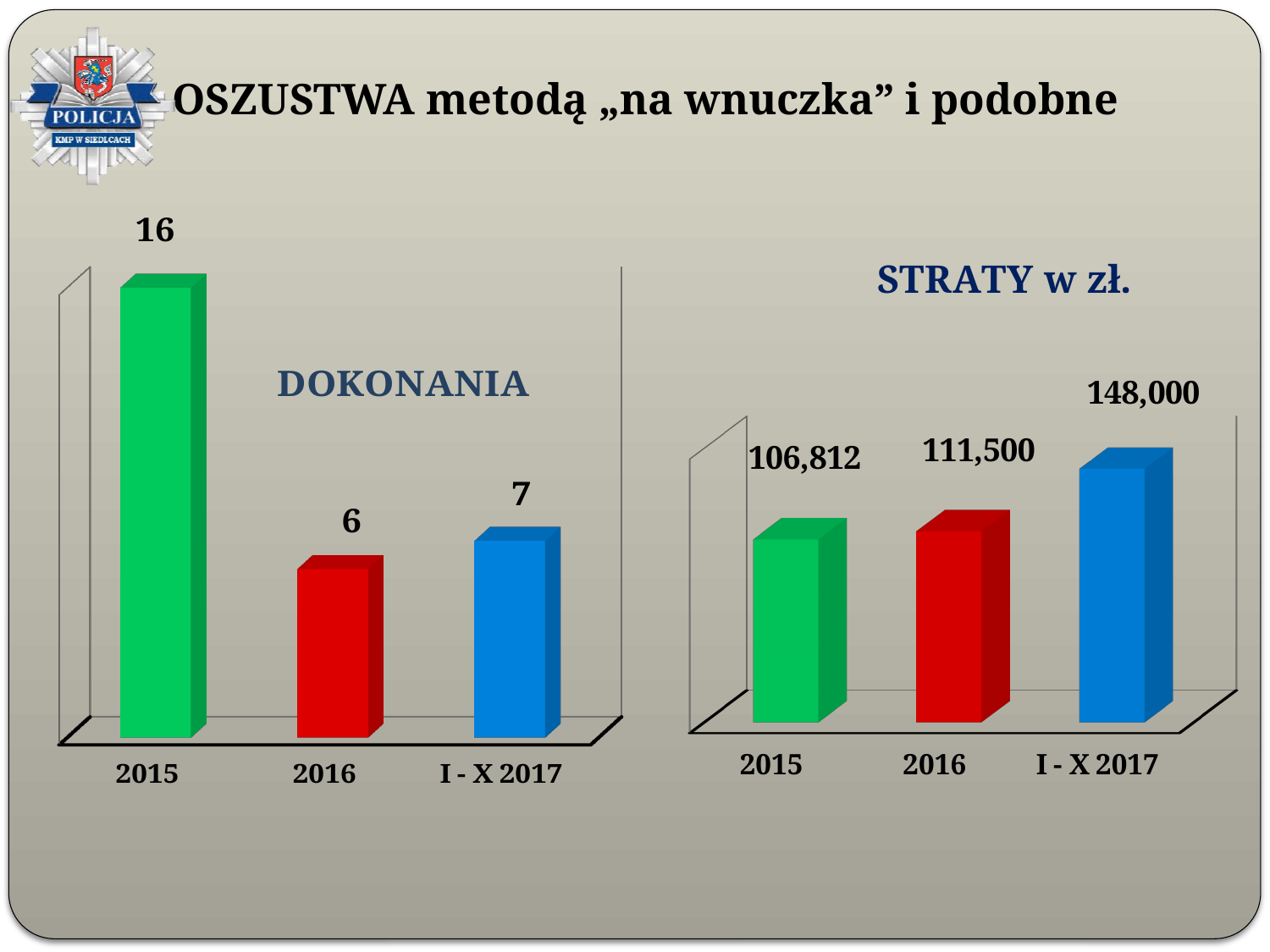
In the DOKONANIA chart, which category has the highest value? 2015 In the DOKONANIA chart, which category has the lowest value? 2016 In the STRATY w zł. chart, what is the value for 2015? 106,812 In the STRATY w zł. chart, which category has the highest value? I - X 2017 In the DOKONANIA chart, what is the value for 2016? 6 In the DOKONANIA chart, what is the value for 2015? 16 In the STRATY w zł. chart, what is the difference between the values for 2016 and 2015? 4,688 In the STRATY w zł. chart, what is the value for I - X 2017? 148,000 How many categories does the DOKONANIA chart show? 3 In the DOKONANIA chart, what is the difference between the values for 2015 and I - X 2017? 9 What kind of chart is the STRATY w zł. chart? bar chart In the STRATY w zł. chart, do the values rise or fall from 2015 to I - X 2017? rise